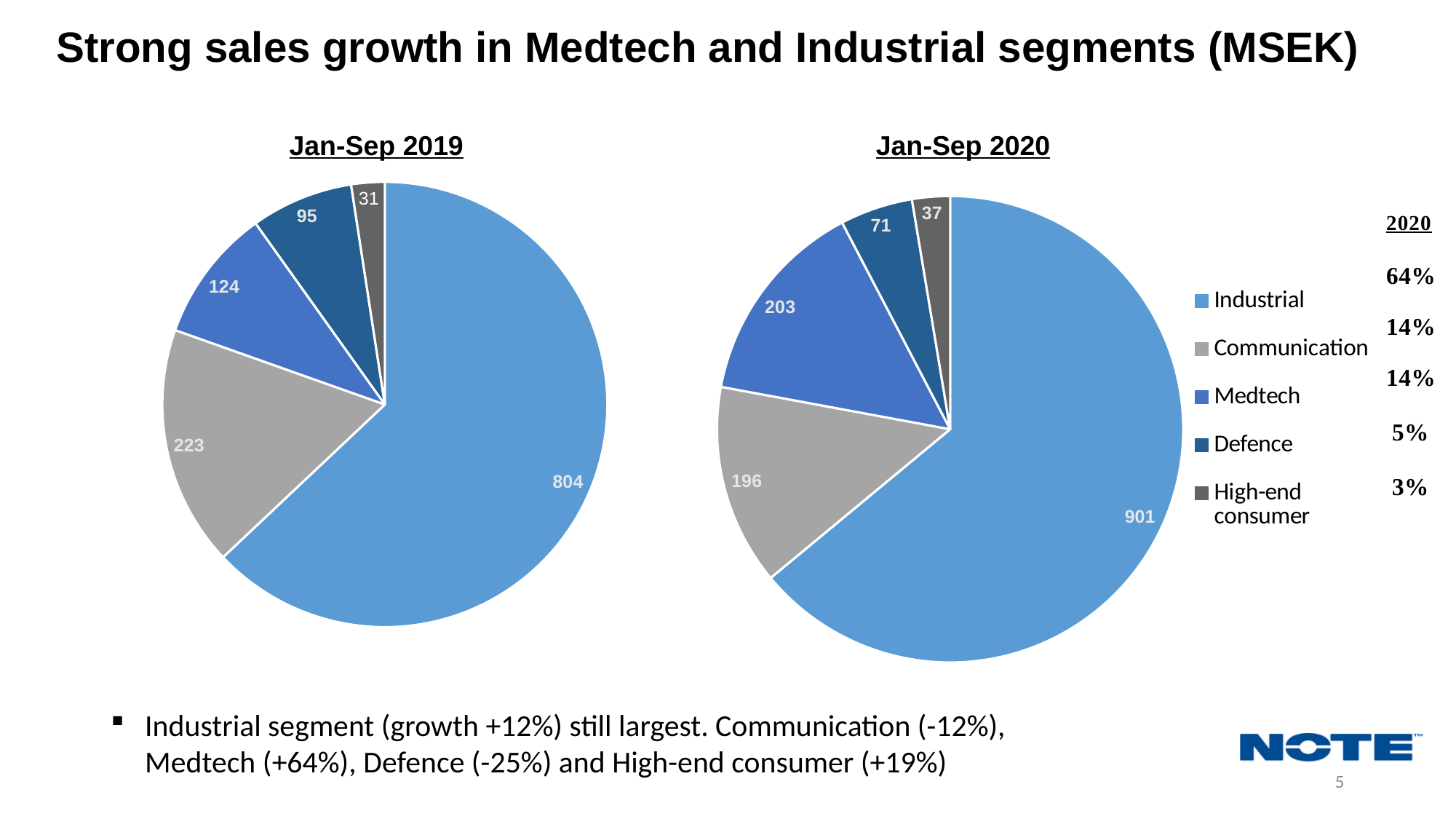
How much larger is the Industrial value in the Jan-Sep 2020 chart than in the Jan-Sep 2019 chart? 97 What is the total of all segments in the Jan-Sep 2020 chart? 1408 In the Jan-Sep 2020 chart, what is the value for Medtech? 203 In the Jan-Sep 2019 chart, what is the value for Industrial? 804 In the Jan-Sep 2020 chart, which segment has the smallest value? High-end consumer What type of charts are shown on the slide? Pie charts In the Jan-Sep 2019 chart, which is larger, Communication or Defence? Communication In the Jan-Sep 2020 chart, what share of the total does Industrial represent? 64% In the Jan-Sep 2019 chart, which segment has the largest value? Industrial How many segments does each pie chart have? 5 What is the difference between the Medtech values in the Jan-Sep 2020 and Jan-Sep 2019 charts? 79 In the Jan-Sep 2019 chart, what is the value for High-end consumer? 31